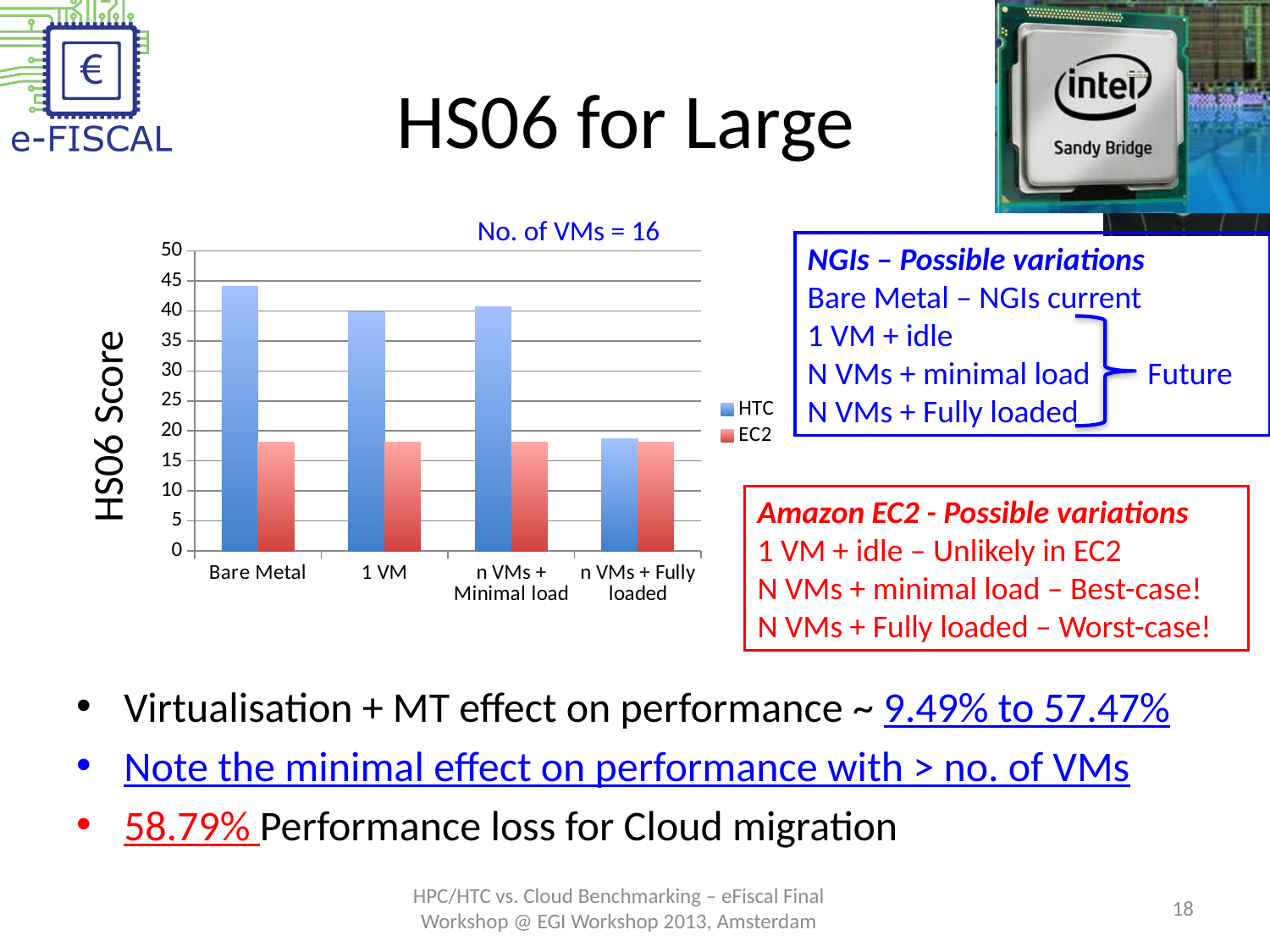
Which category has the lowest HTC value? n VMs + Fully loaded What is the label on the y axis of the chart? HS06 Score Which colour represents the EC2 series in the chart? red Is the EC2 value for Bare Metal greater or less than 20? less Is the HTC value for n VMs + Fully loaded greater or less than 20? less How many series does the chart legend list? 2 What kind of chart is shown on the slide? bar chart Is the HTC value for 1 VM greater or less than 35? greater For Bare Metal, which series has the larger value, HTC or EC2? HTC How many categories are shown on the x axis of the chart? 4 Which category has the highest HTC value? Bare Metal